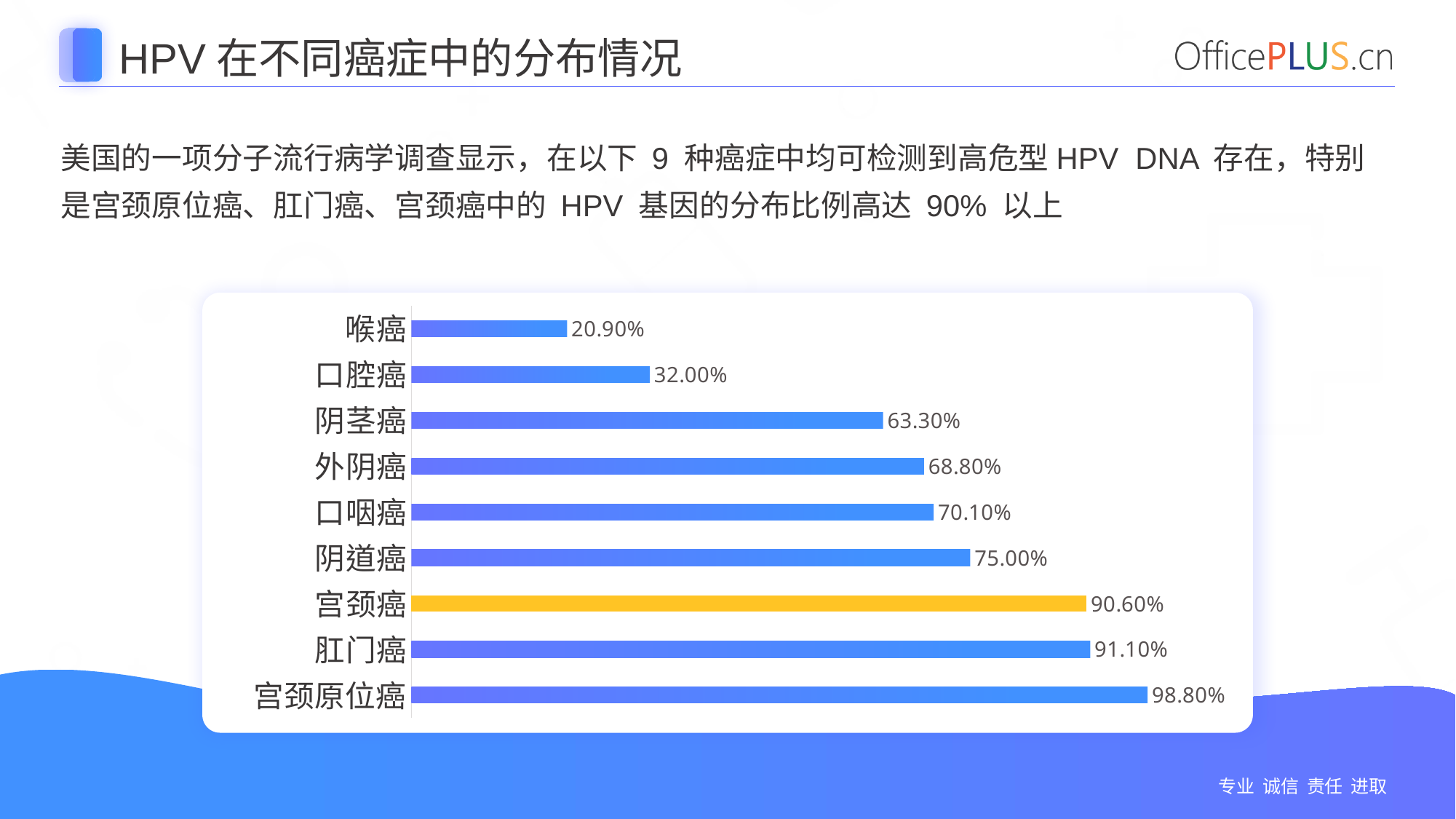
Which category has the highest value? 宫颈原位癌 How many categories are shown in the chart? 9 Which category has the lowest value? 喉癌 What is the difference between the values for 口腔癌 and 喉癌? 11.10% What is the value for 口咽癌? 70.10% What is the value for 喉癌? 20.90% What is the value for 宫颈癌? 90.60% Which is larger, the value for 阴道癌 or the value for 外阴癌? 阴道癌 What kind of chart is shown on the slide? Bar chart What is the difference between the values for 宫颈原位癌 and 肛门癌? 7.70% Which category's bar is coloured yellow instead of blue? 宫颈癌 What is the title of the slide containing the chart? HPV 在不同癌症中的分布情况